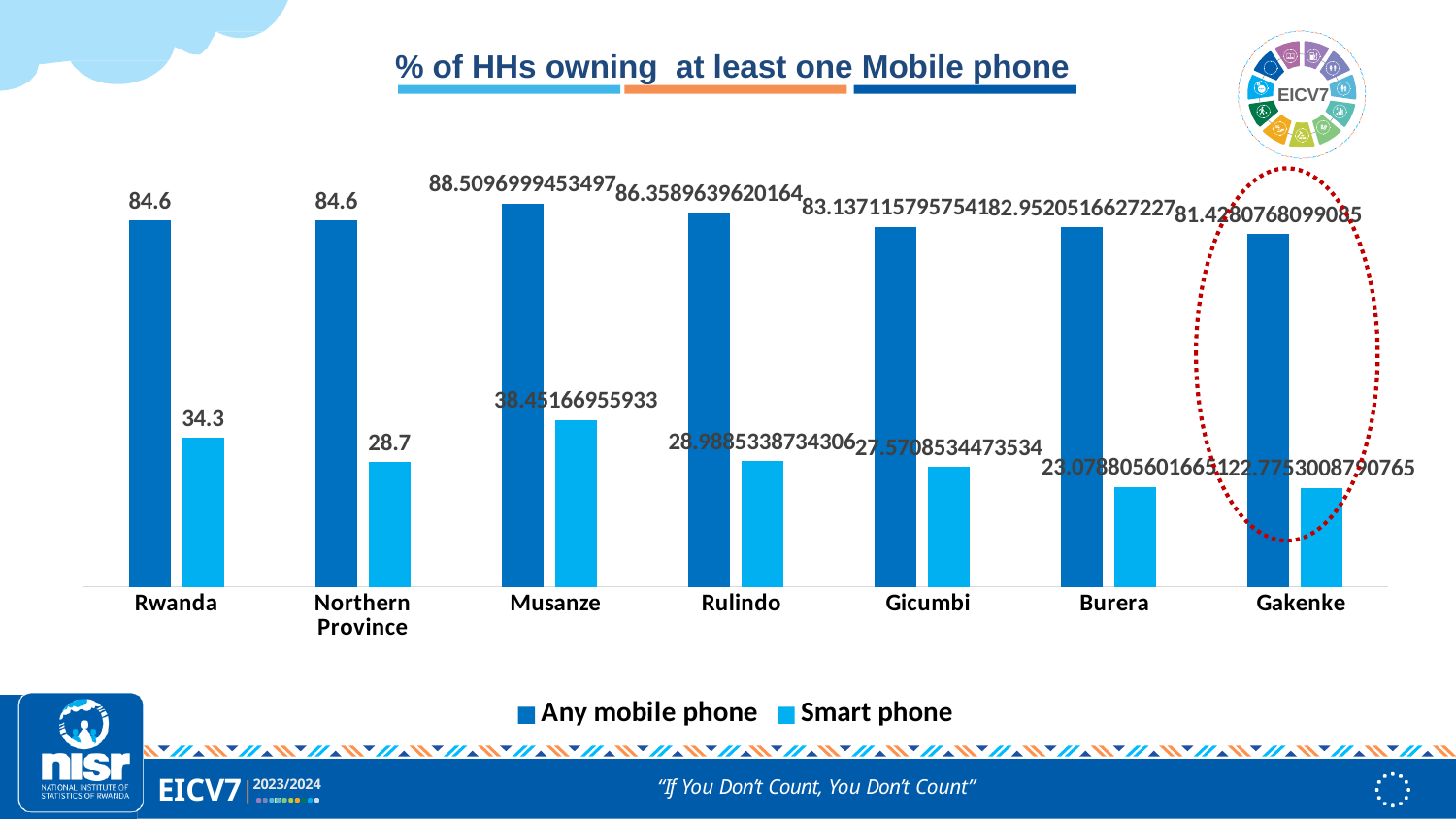
What is the difference between the Any mobile phone and Smart phone values for Rwanda? 50.3 Which category has the highest Any mobile phone value? Musanze Which is larger: the Smart phone value for Musanze or for Rwanda? Musanze How many series does the legend list? 2 What is the Any mobile phone value for Northern Province? 84.6 How many categories are shown on the x axis? 7 What type of chart is shown on the slide? Bar chart What is the Smart phone value for Rwanda? 34.3 Which category has the highest Smart phone value? Musanze What percentage of households in Rwanda own any mobile phone? 84.6 What is the Smart phone value for Northern Province? 28.7 How much higher is the Smart phone value for Rwanda than for Northern Province? 5.6